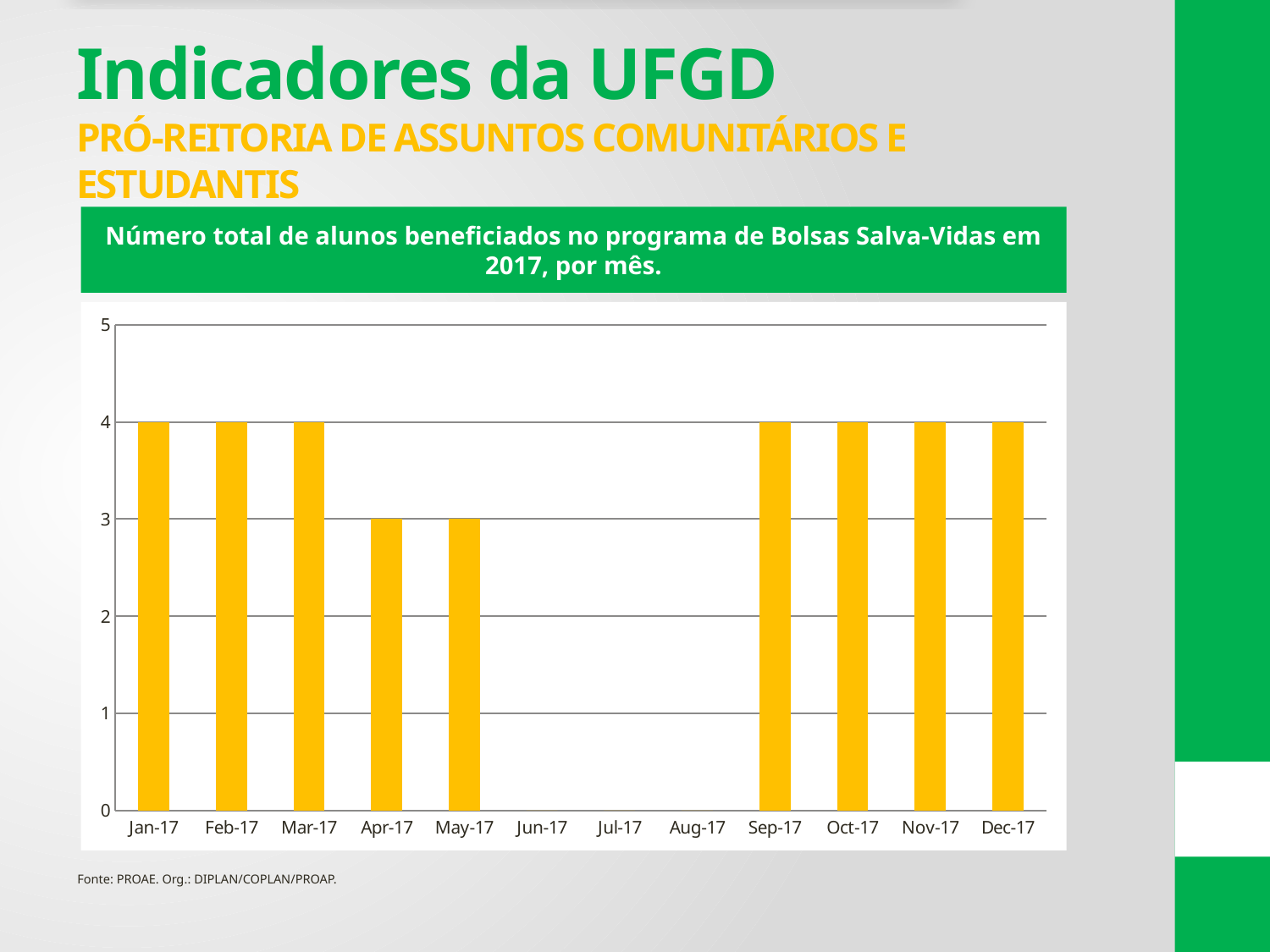
What is the value for Jan-17? 4 What is the value for Jul-17? 0 What is the value for May-17? 3 What is the value for Apr-17? 3 What is the difference between the values for Mar-17 and Apr-17? 1 What is the title of the chart? Número total de alunos beneficiados no programa de Bolsas Salva-Vidas em 2017, por mês. Is the value for Sep-17 greater or less than 3? greater What kind of chart is shown on the slide? Bar chart How many months have no bar (a value of 0)? 3 Do the values rise or fall from Mar-17 to May-17? Fall Which is larger, the value for Feb-17 or the value for May-17? Feb-17 How many months are shown on the x axis? 12